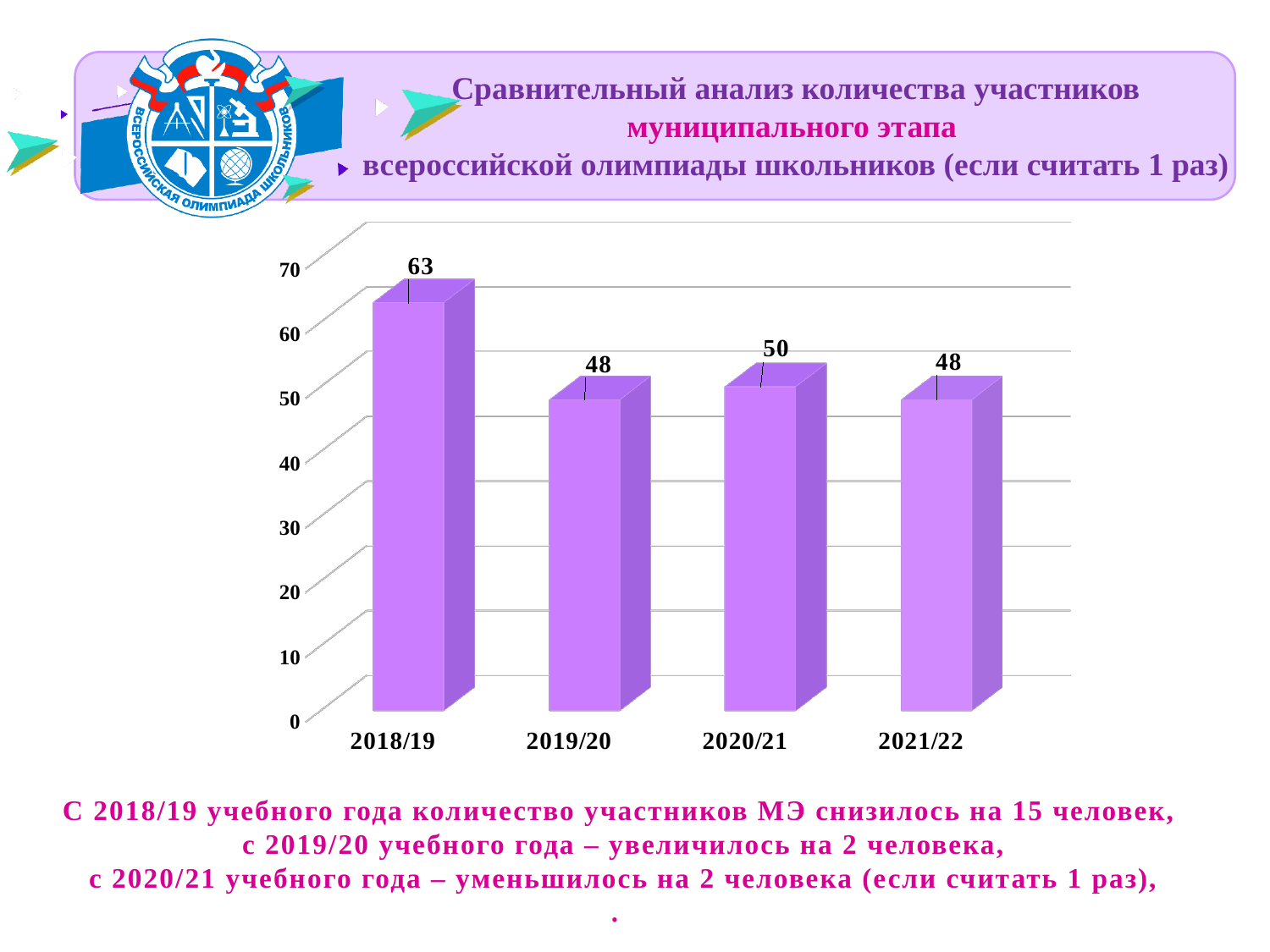
Does the value rise or fall from 2018/19 to 2019/20? fall What is the value for 2021/22? 48 What kind of chart is shown on the slide? bar chart What is the value for 2020/21? 50 What is the difference between the values for 2018/19 and 2019/20? 15 Is the value for 2018/19 greater or less than 60? greater Which year has the highest value? 2018/19 Which is larger, the value for 2019/20 or the value for 2020/21? 2020/21 What is the value for 2018/19? 63 What is the difference between the values for 2020/21 and 2021/22? 2 What colour are the bars in the chart? purple How many years are shown on the x axis? 4